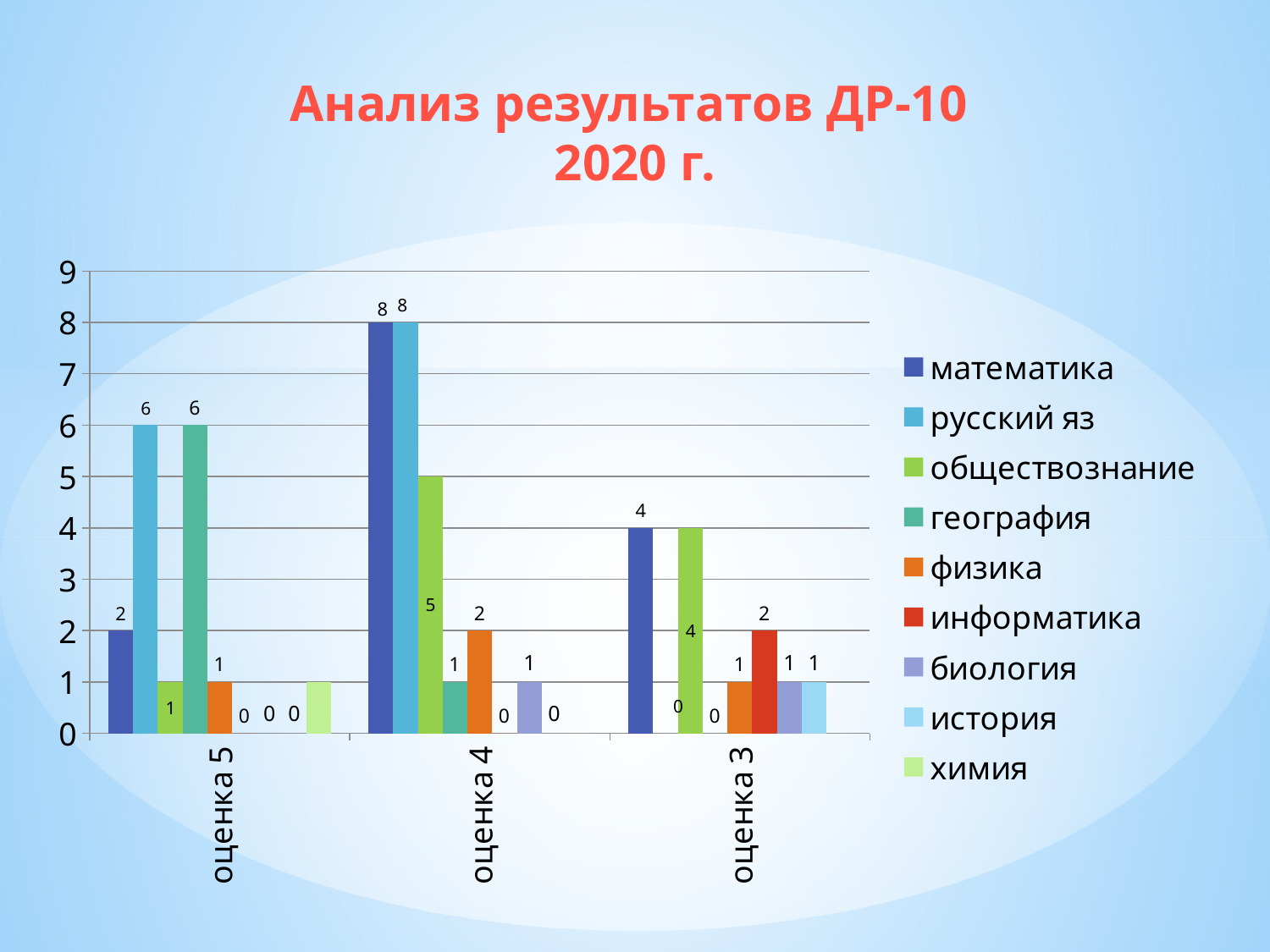
What is the value for география in the оценка 5 category? 6 What is the value for математика in the оценка 4 category? 8 What kind of chart is shown on the slide? bar chart How many categories are shown on the x axis? 3 What is the value for информатика in the оценка 3 category? 2 What is the value for обществознание in the оценка 4 category? 5 In which category does математика have its lowest value? оценка 5 In which category does математика have its highest value? оценка 4 What is the difference between the математика values for оценка 4 and оценка 3? 4 How many series does the legend list? 9 What is the value for русский яз in the оценка 5 category? 6 Which category has the larger value for обществознание, оценка 4 or оценка 3? оценка 4